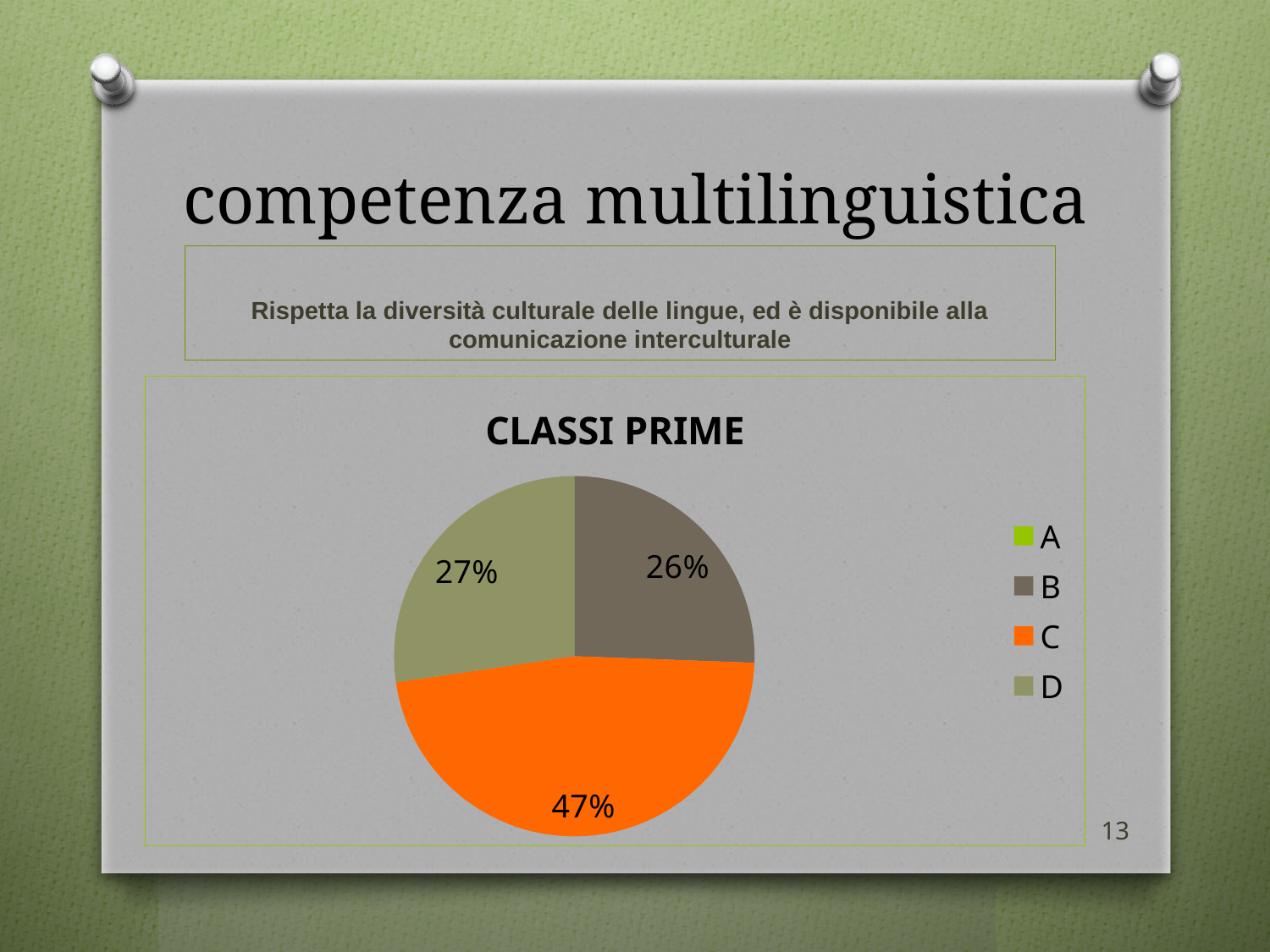
Which is larger, the share for C or the share for D? C Which slice has the largest share of the pie? C How many entries does the legend list? 4 What percentage of the pie does slice D represent? 27% What percentage of the pie does slice B represent? 26% Which of the labelled slices has the smallest share of the pie? B What is the difference in percentage points between slice C and slice B? 21 How many slices with percentage labels are visible in the pie? 3 What colour is slice C in the pie chart? orange What is the title of the chart? CLASSI PRIME What kind of chart is shown on the slide? pie chart What percentage of the pie does slice C represent? 47%